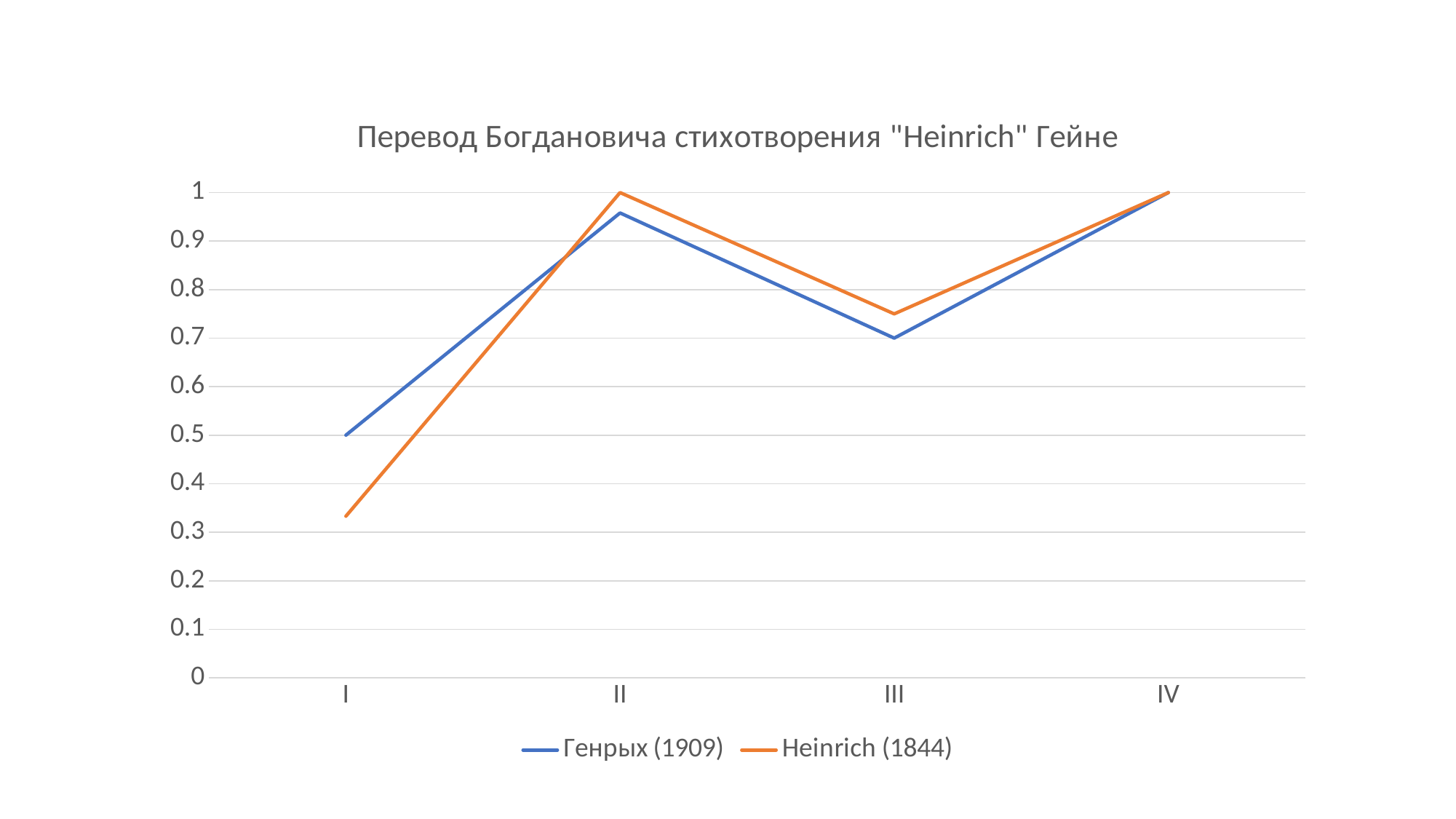
Do the values for Heinrich (1844) rise or fall from category I to category II? rise How many categories are shown on the x axis? 4 What is the value for Heinrich (1844) at category II? 1 Which category has the lowest value for Генрых (1909)? I What is the value for Генрых (1909) at category III? 0.7 How many series does the legend list? 2 What kind of chart is shown on the slide? line chart At category III, which series has the higher value, Генрых (1909) or Heinrich (1844)? Heinrich (1844) Is the value for Heinrich (1844) at category I greater or less than 0.4? less At category I, which series has the higher value, Генрых (1909) or Heinrich (1844)? Генрых (1909) What is the value for Генрых (1909) at category I? 0.5 Is the value for Heinrich (1844) at category III greater or less than 0.8? less